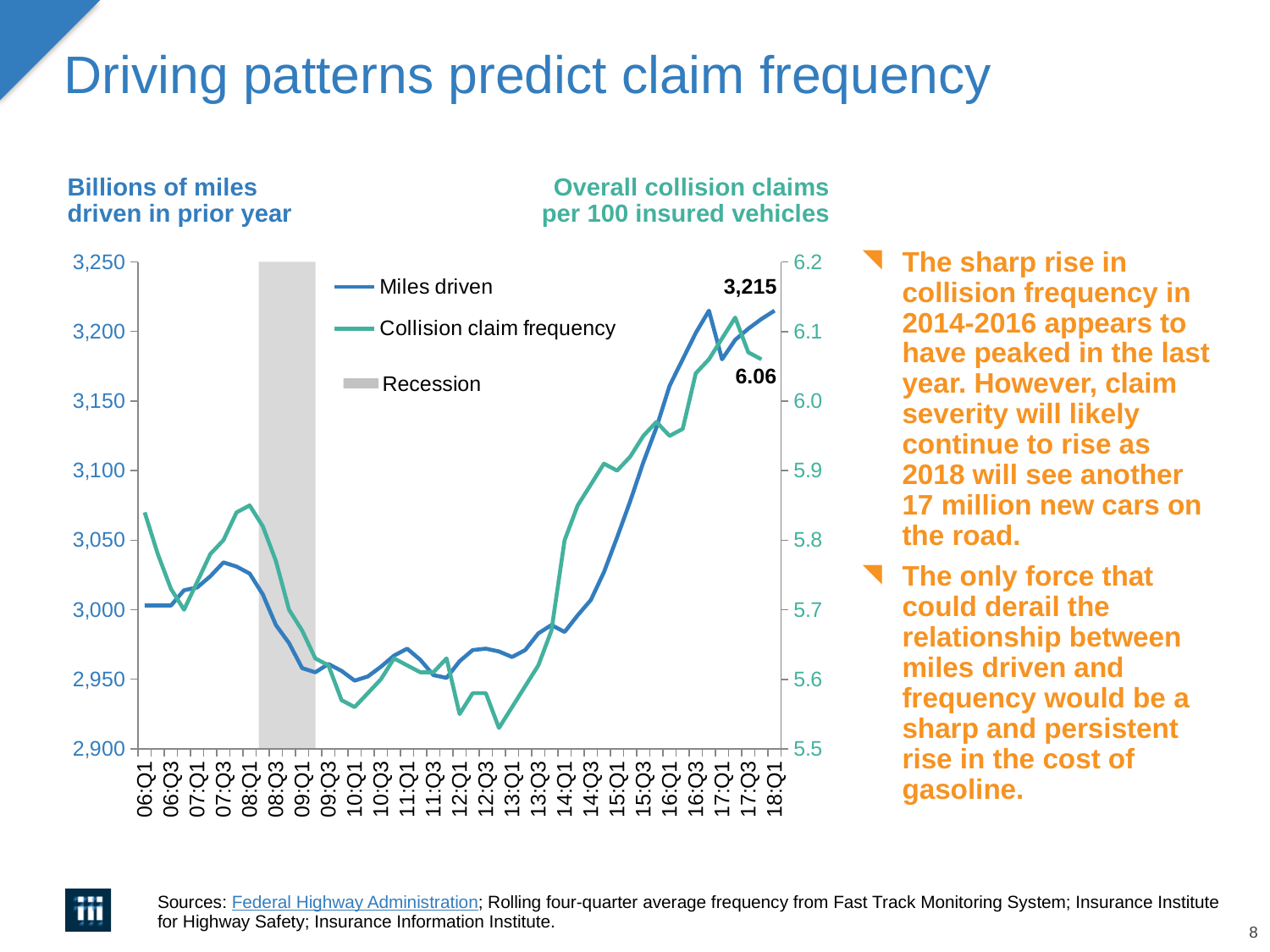
What kind of chart is shown on the slide? Line chart How many entries does the chart legend list? 3 Does the miles driven line rise or fall from 13:Q1 to 18:Q1? rise Is the value for miles driven at 15:Q1 greater or less than 3,100? less Does the collision claim frequency line rise or fall from 08:Q1 to 09:Q3? fall What is the title of the left axis of the chart? Billions of miles driven in prior year What is the value of miles driven at 18:Q1? 3,215 Is the value for miles driven at 10:Q1 greater or less than 3,000? less In which quarter is the collision claim frequency at its lowest? 12:Q4 Is the collision claim frequency at 14:Q3 greater or less than 5.8? greater